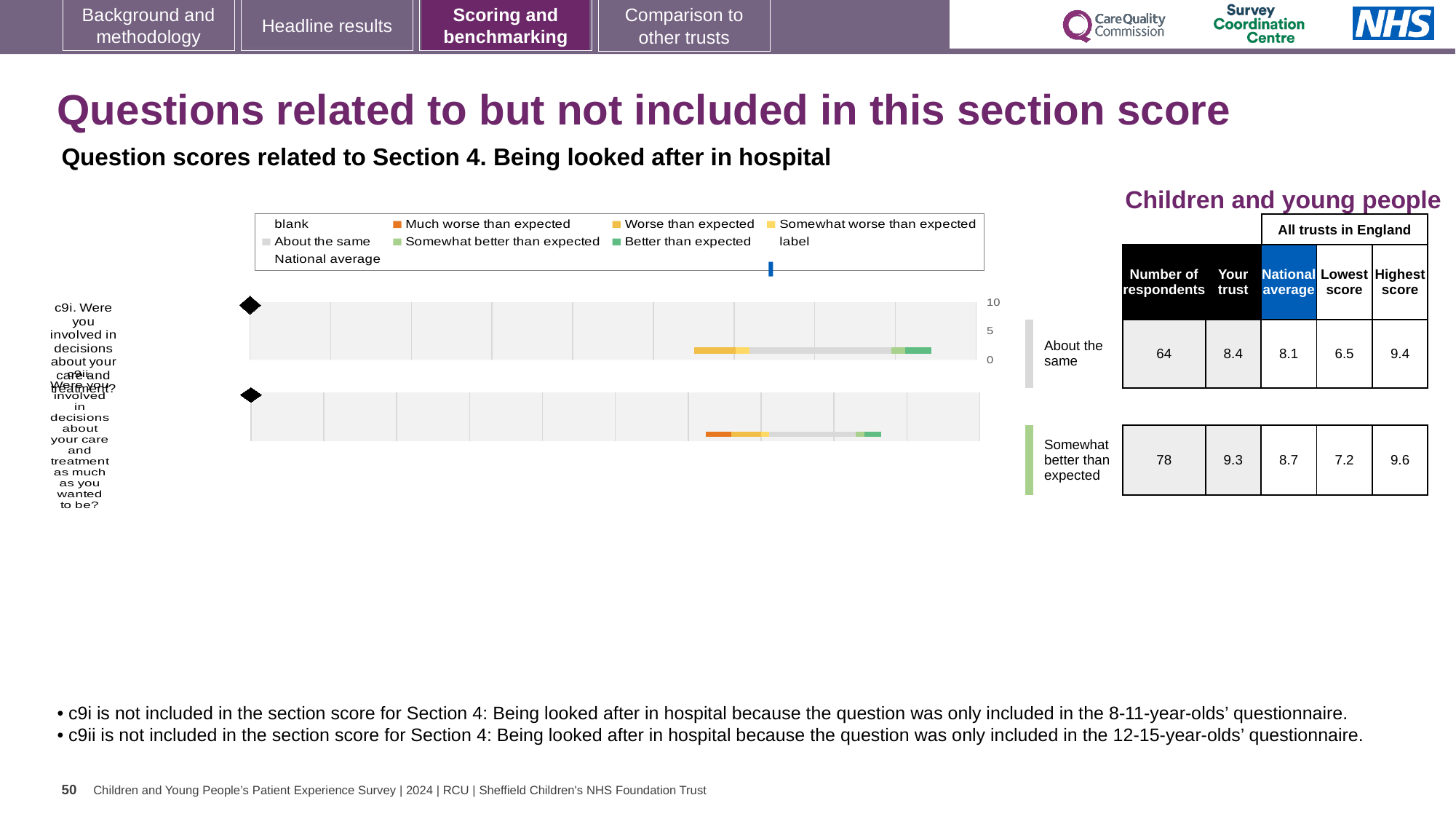
What is the 'Your trust' score for question c9i? 8.4 What is the highest score across all trusts in England for question c9ii? 9.6 How many respondents answered question c9ii? 78 What is the difference between the highest and lowest scores across all trusts for question c9i? 2.9 Which question has the higher 'Your trust' score, c9i or c9ii? c9ii What kind of chart is used to show the question scores for c9i and c9ii? Bar chart What benchmark category is shown for question c9ii? Somewhat better than expected What is the 'Your trust' score for question c9ii? 9.3 What is the difference between the trust score and the national average for question c9ii? 0.6 What is the national average score for question c9i? 8.1 How many questions (categories) are plotted in the chart? 2 How many entries does the chart legend list? 9